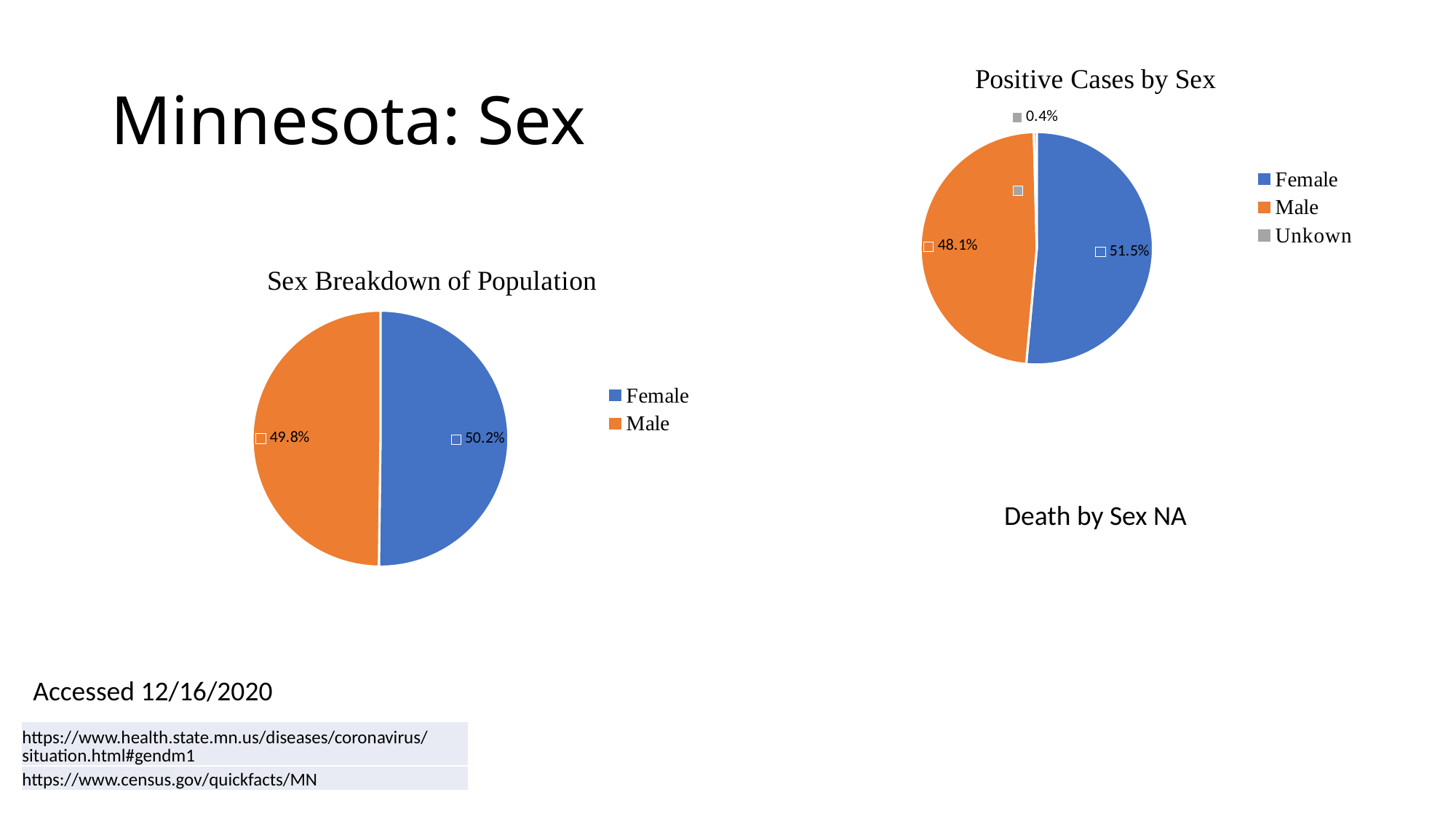
In the 'Positive Cases by Sex' chart, what is the difference between the Female and Male percentages? 3.4% In the 'Positive Cases by Sex' chart, which category has the smallest share? Unkown In the 'Positive Cases by Sex' chart, which category has the largest share? Female In the 'Sex Breakdown of Population' chart, what share of the population is Male? 49.8% In the 'Positive Cases by Sex' chart, what percentage of positive cases are Male? 48.1% What type of chart is 'Positive Cases by Sex'? Pie chart In the 'Positive Cases by Sex' chart, what percentage of positive cases are Female? 51.5% In the 'Positive Cases by Sex' chart, what percentage of positive cases are Unknown? 0.4% How many slices does the 'Sex Breakdown of Population' chart have? 2 In the 'Sex Breakdown of Population' chart, what is the difference between the Female and Male shares? 0.4% How many categories does the legend of the 'Positive Cases by Sex' chart list? 3 In the 'Sex Breakdown of Population' chart, what share of the population is Female? 50.2%